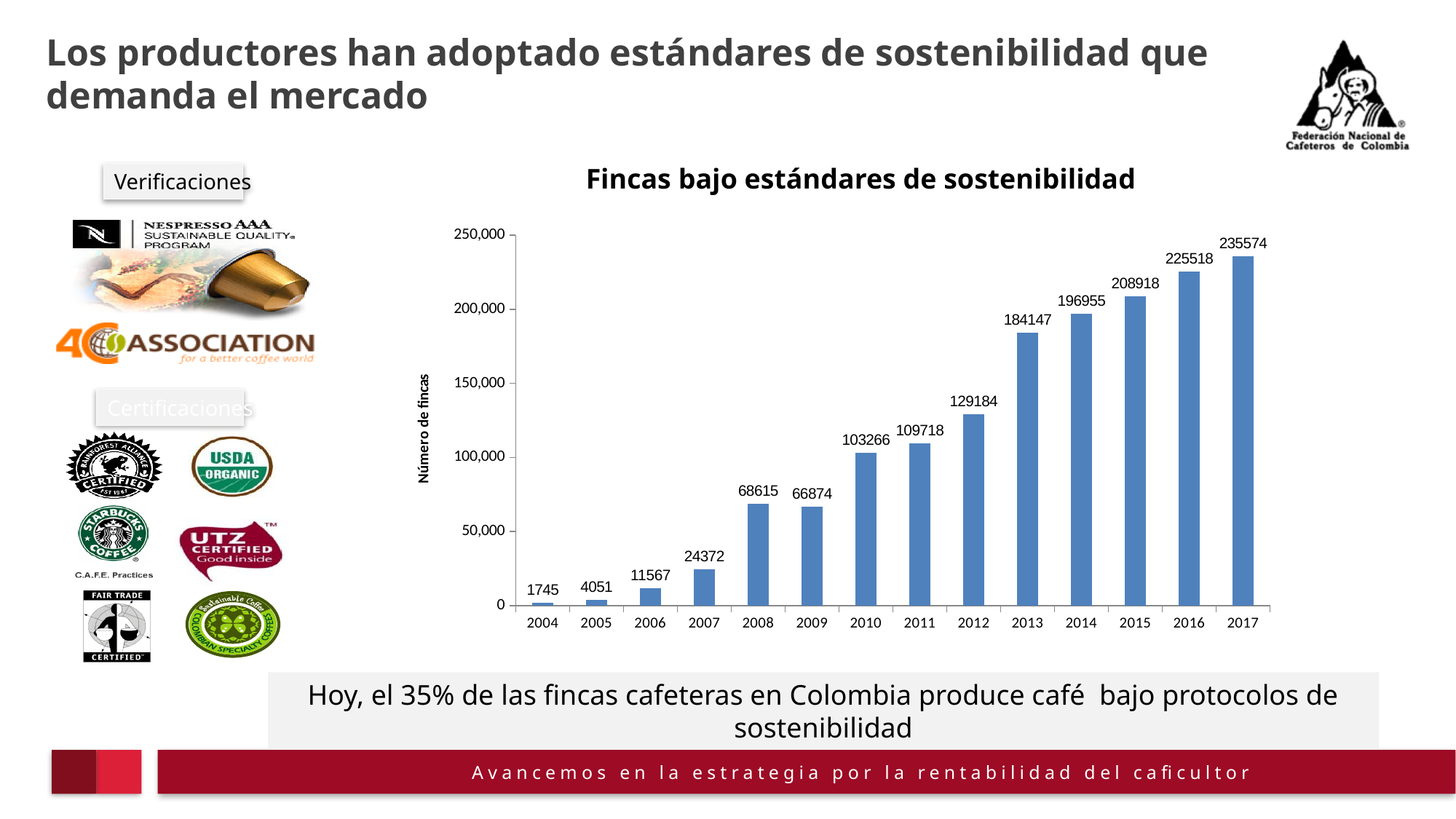
Do the values generally rise or fall from 2004 to 2017? rise How many years are shown on the x axis of the chart? 14 What is the difference between the values for 2017 and 2016? 10056 What is the value for 2004 in the chart? 1745 What is the label of the vertical axis of the chart? Número de fincas Which is larger, the value for 2008 or the value for 2009? 2008 Is the value for 2013 greater or less than 150,000? greater What is the value for 2010 in the chart? 103266 What kind of chart is shown on the slide? bar chart What is the value for 2017 in the chart 'Fincas bajo estándares de sostenibilidad'? 235574 Which year has the highest number of fincas? 2017 Which year has the lowest number of fincas? 2004